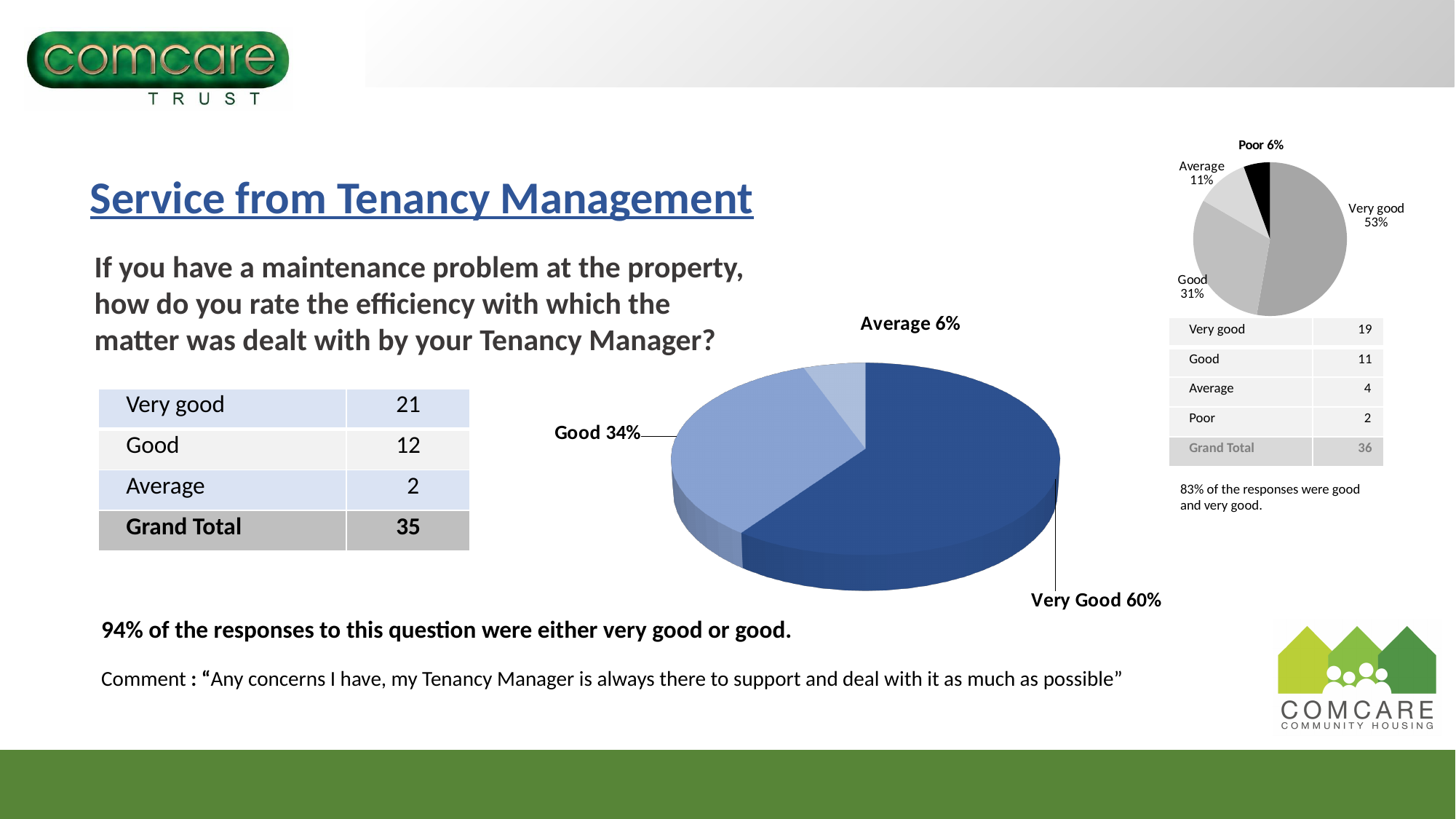
On the large blue pie chart in the centre of the slide, what share is labelled for Good? 34% On the large blue pie chart in the centre of the slide, what is the difference in percentage points between Very Good and Good? 26 On the small grey pie chart in the top right of the slide, which is larger, Good or Average? Good On the large blue pie chart in the centre of the slide, what share is labelled for Average? 6% On the small grey pie chart in the top right of the slide, how many slices are there? 4 On the large blue pie chart in the centre of the slide, which category has the largest slice? Very Good On the small grey pie chart in the top right of the slide, what share is labelled for Very good? 53% What kind of chart is the large chart in the centre of the slide? Pie chart On the large blue pie chart in the centre of the slide, which category has the smallest slice? Average On the large blue pie chart in the centre of the slide, how many slices are there? 3